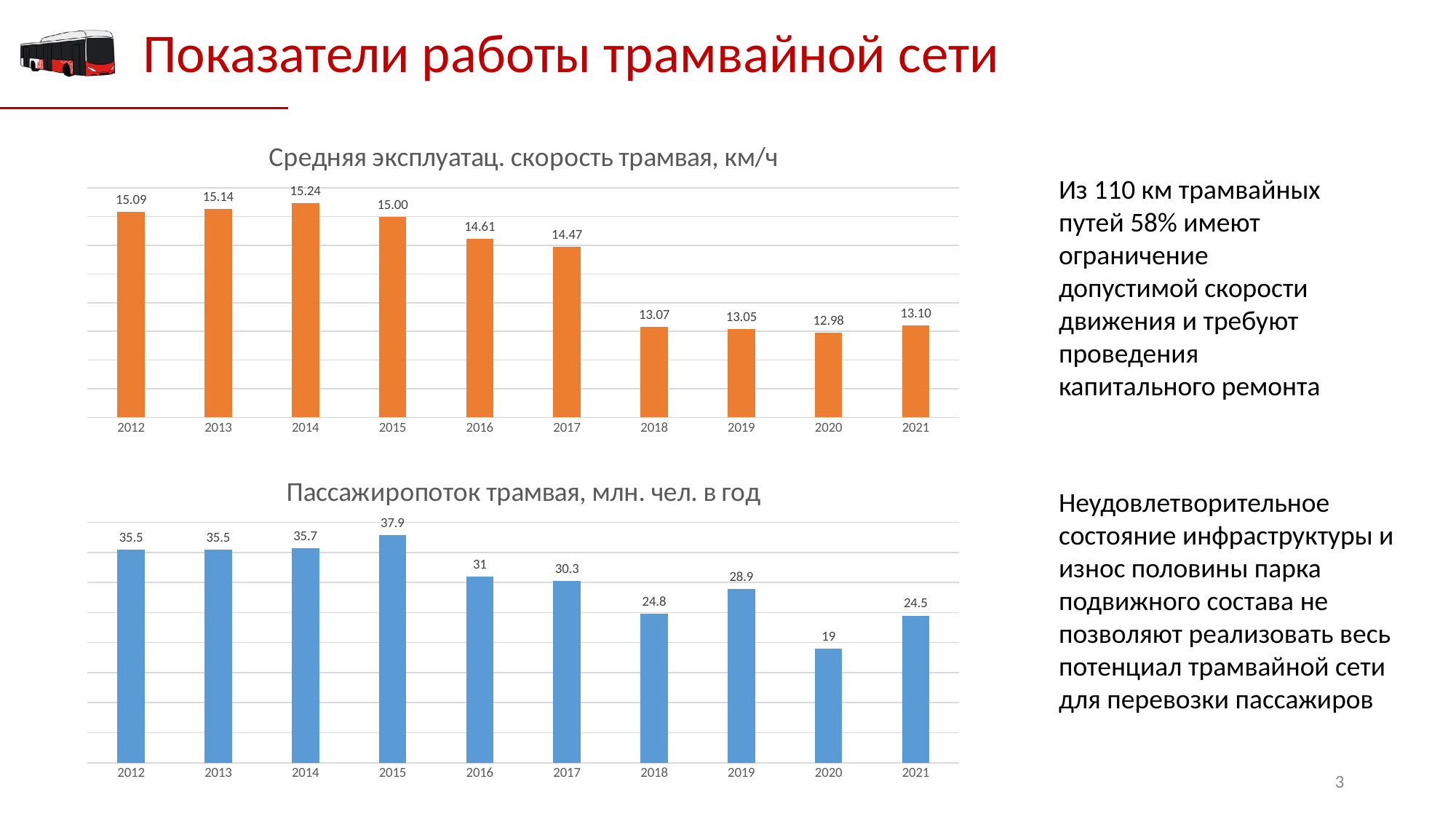
In the chart 'Пассажиропоток трамвая, млн. чел. в год', what is the value for 2020? 19 In the chart 'Средняя эксплуатац. скорость трамвая, км/ч', what is the difference between the values for 2017 and 2018? 1.40 In the chart 'Средняя эксплуатац. скорость трамвая, км/ч', which year has the highest value? 2014 In the chart 'Средняя эксплуатац. скорость трамвая, км/ч', how many years are shown on the x axis? 10 In the chart 'Средняя эксплуатац. скорость трамвая, км/ч', which year has the lowest value? 2020 What type of chart is 'Пассажиропоток трамвая, млн. чел. в год'? bar chart In the chart 'Пассажиропоток трамвая, млн. чел. в год', which year has the highest value? 2015 In the chart 'Пассажиропоток трамвая, млн. чел. в год', which is larger, the value for 2019 or the value for 2021? 2019 In the chart 'Пассажиропоток трамвая, млн. чел. в год', what is the difference between the values for 2015 and 2020? 18.9 In the chart 'Средняя эксплуатац. скорость трамвая, км/ч', what is the value for 2014? 15.24 In the chart 'Средняя эксплуатац. скорость трамвая, км/ч', do the values generally rise or fall from 2014 to 2020? fall What colour are the bars in the chart 'Средняя эксплуатац. скорость трамвая, км/ч'? orange